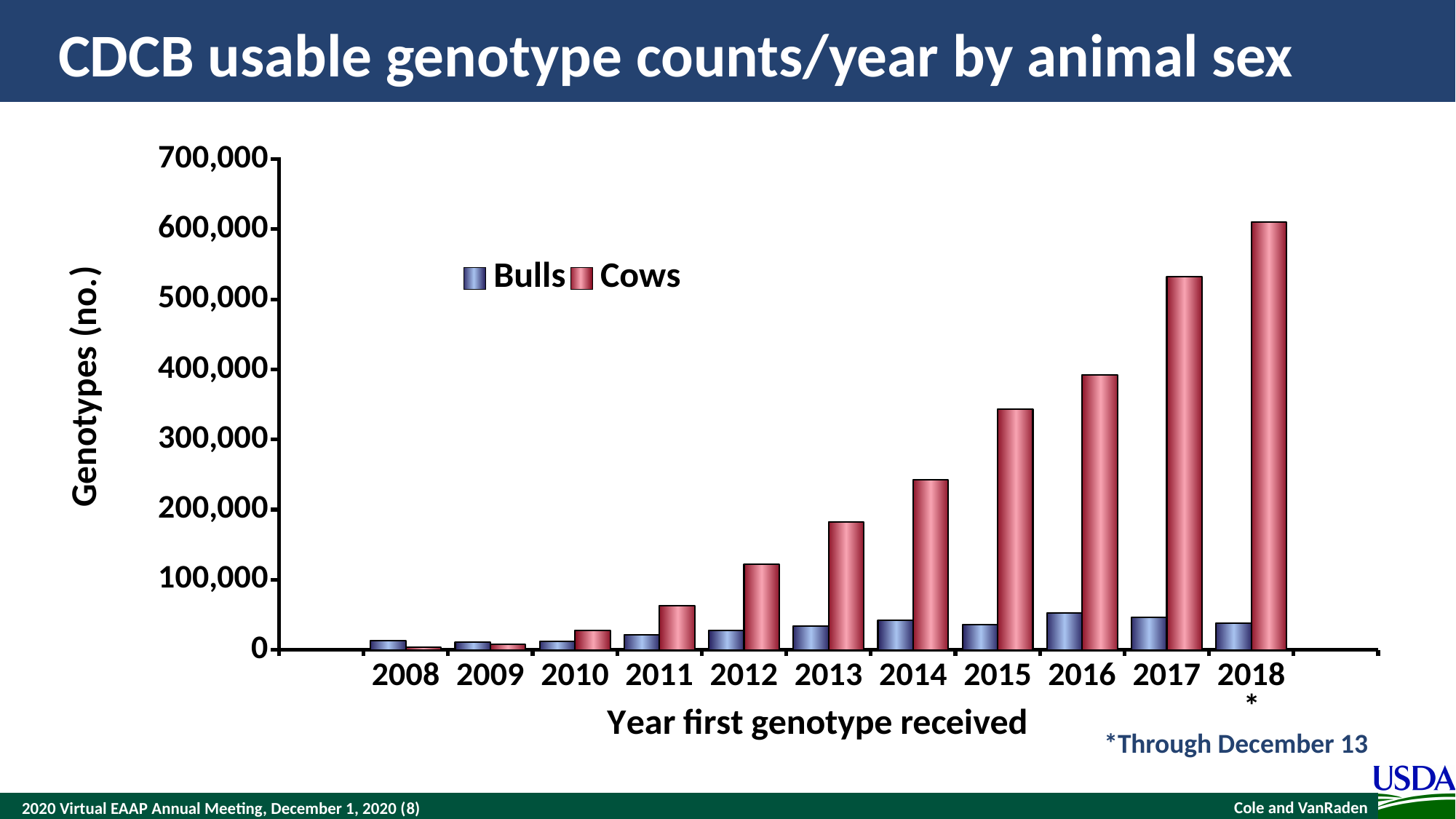
What kind of chart is shown on the slide? Bar chart Is the value for Bulls in 2016 greater or less than 100,000? less Is the value for Cows in 2017 greater or less than 500,000? greater Is the value for Cows in 2012 greater or less than 100,000? greater In 2008, which is larger, the value for Bulls or the value for Cows? Bulls How many series does the legend list? 2 What is the label on the y axis? Genotypes (no.) Do the values for Cows rise or fall from 2008 to 2018? Rise Which year has the highest value for Cows? 2018 Which year has the lowest value for Cows? 2008 How many years are shown on the x axis? 11